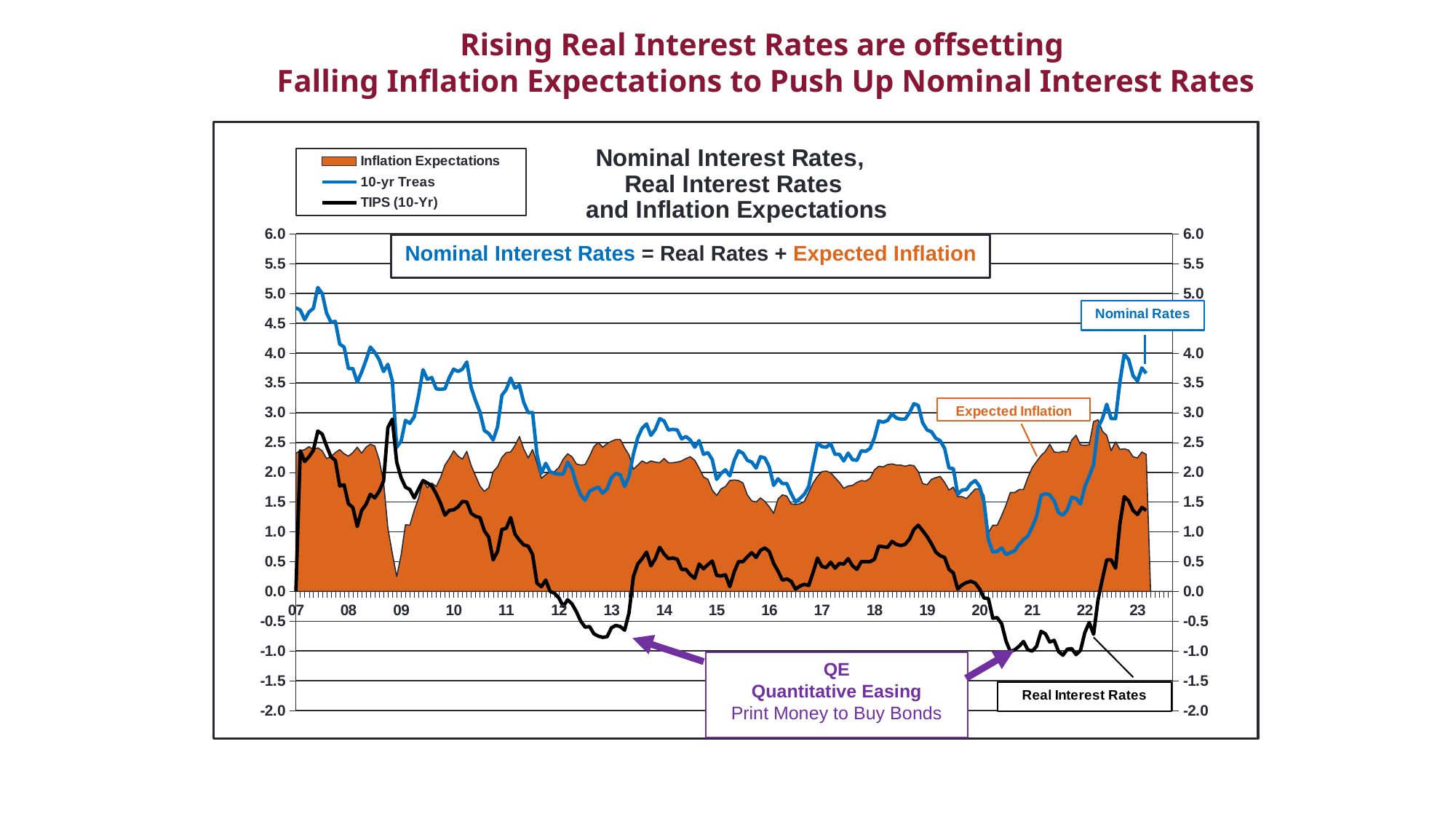
In 2021, which is higher, 10-yr Treas or TIPS (10-Yr)? 10-yr Treas What kind of chart is this? combination area and line chart Is the lowest value of TIPS (10-Yr) in 2021 greater or less than -0.5? less Does the 10-yr Treas series rise or fall from 2020 to 2023? rise Is the lowest value of TIPS (10-Yr) in 2013 greater or less than 0.0? less Is the lowest value of Inflation Expectations in 2009 greater or less than 1.0? less How many series does the legend list? 3 What is the title of the chart? Nominal Interest Rates, Real Interest Rates and Inflation Expectations What colour is the Inflation Expectations series? orange How many year labels are shown on the x axis? 17